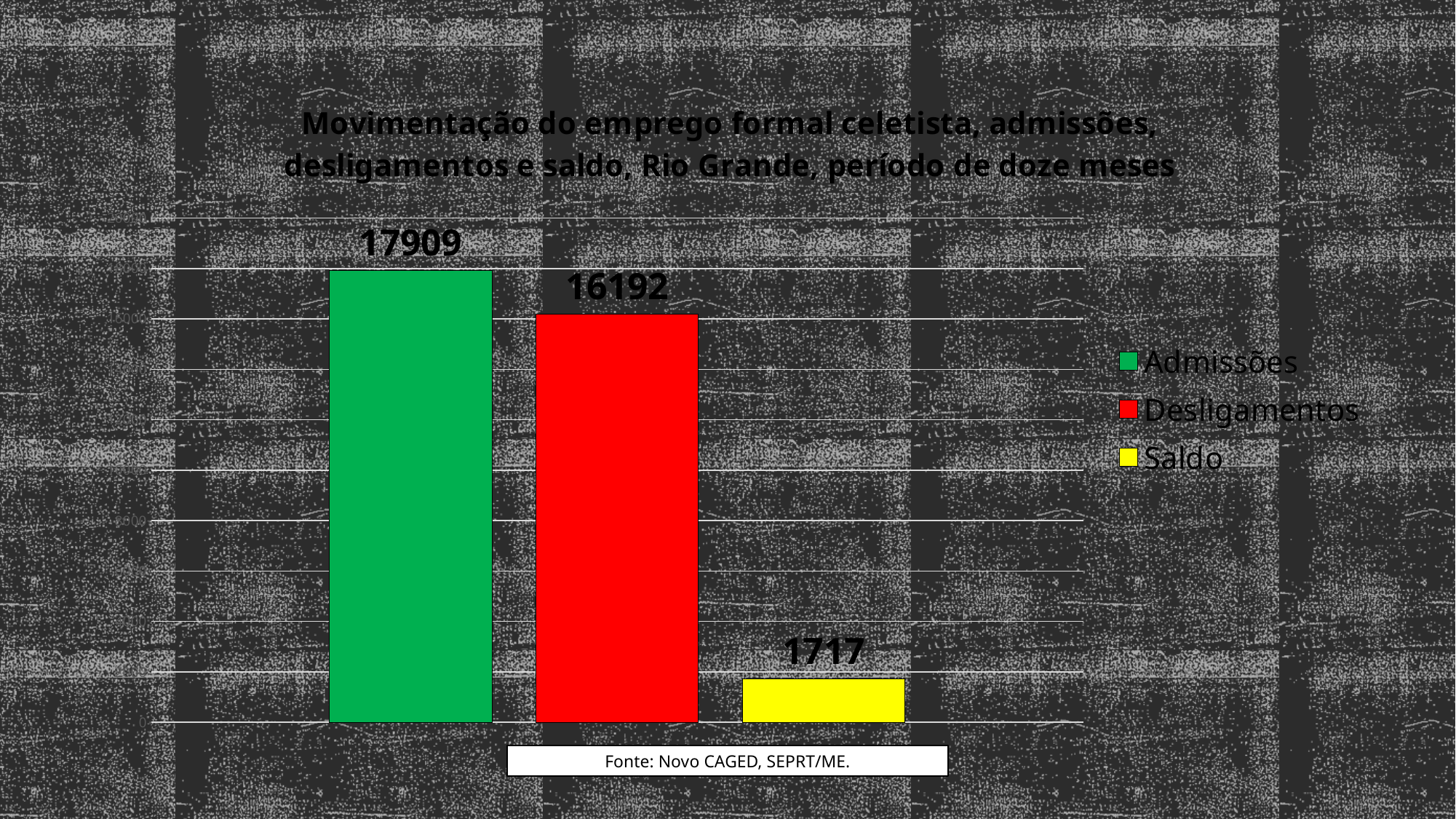
What is the value of the Admissões bar? 17909 How many bars are plotted in the chart? 3 How many series does the legend list? 3 Which series has the highest value? Admissões What is the difference between Admissões and Desligamentos? 1717 What is the difference between Desligamentos and Saldo? 14475 What is the value of the Saldo bar? 1717 What colour is the Saldo bar? Yellow Which is larger, Admissões or Desligamentos? Admissões What is the value of the Desligamentos bar? 16192 Which series has the lowest value? Saldo What kind of chart is shown on the slide? Bar chart